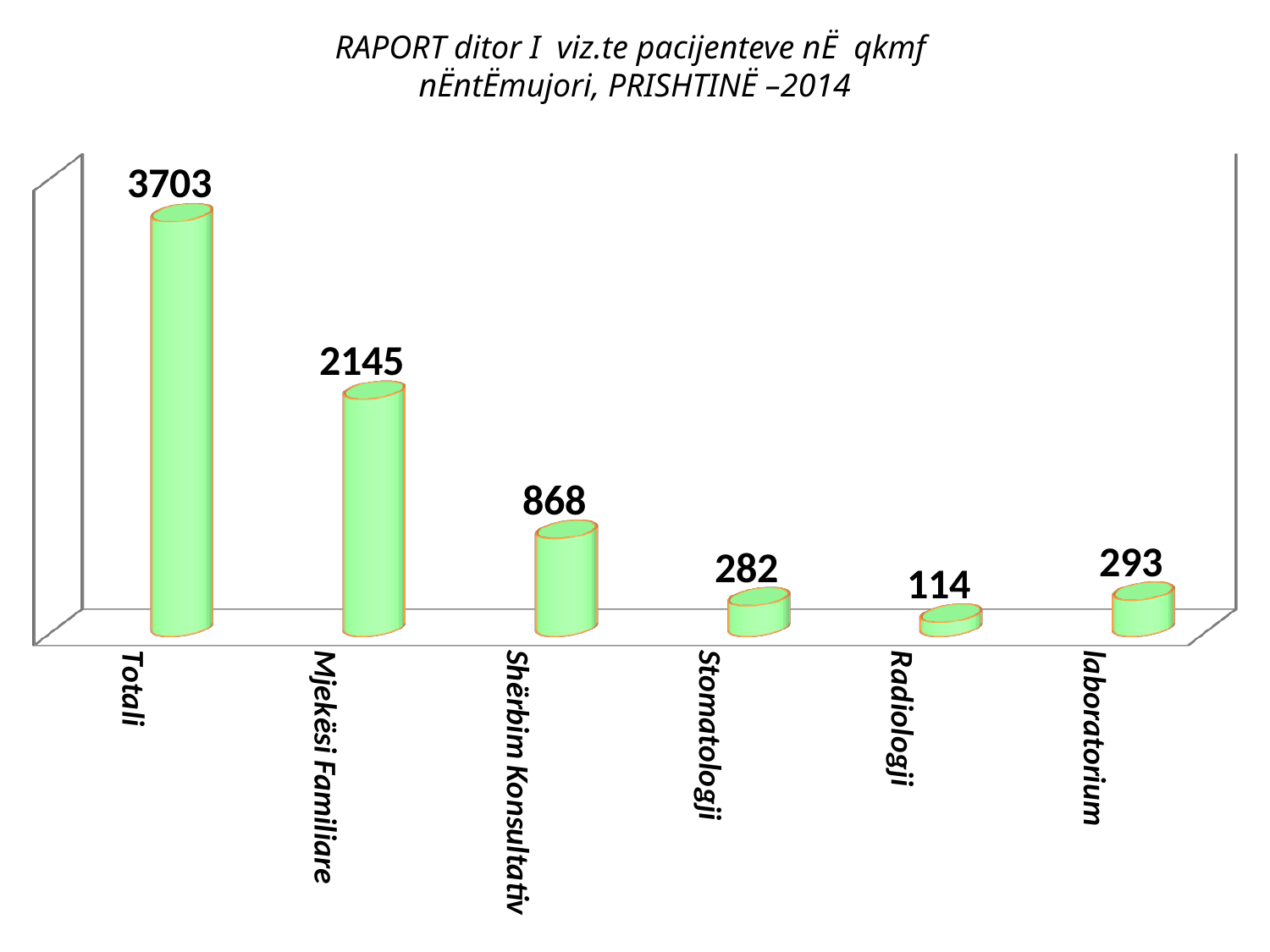
What is the value for Totali? 3703 What is the value for Shërbim Konsultativ? 868 Which category has the highest value? Totali What is the value for laboratorium? 293 What is the value for Mjekësi Familiare? 2145 How many categories are shown on the x axis? 6 What is the difference between the values for Mjekësi Familiare and Shërbim Konsultativ? 1277 What is the difference between the values for Stomatologji and Radiologji? 168 Which is larger, the value for Stomatologji or the value for laboratorium? laboratorium What is the value for Radiologji? 114 What kind of chart is shown on the slide? bar chart Which category has the lowest value? Radiologji